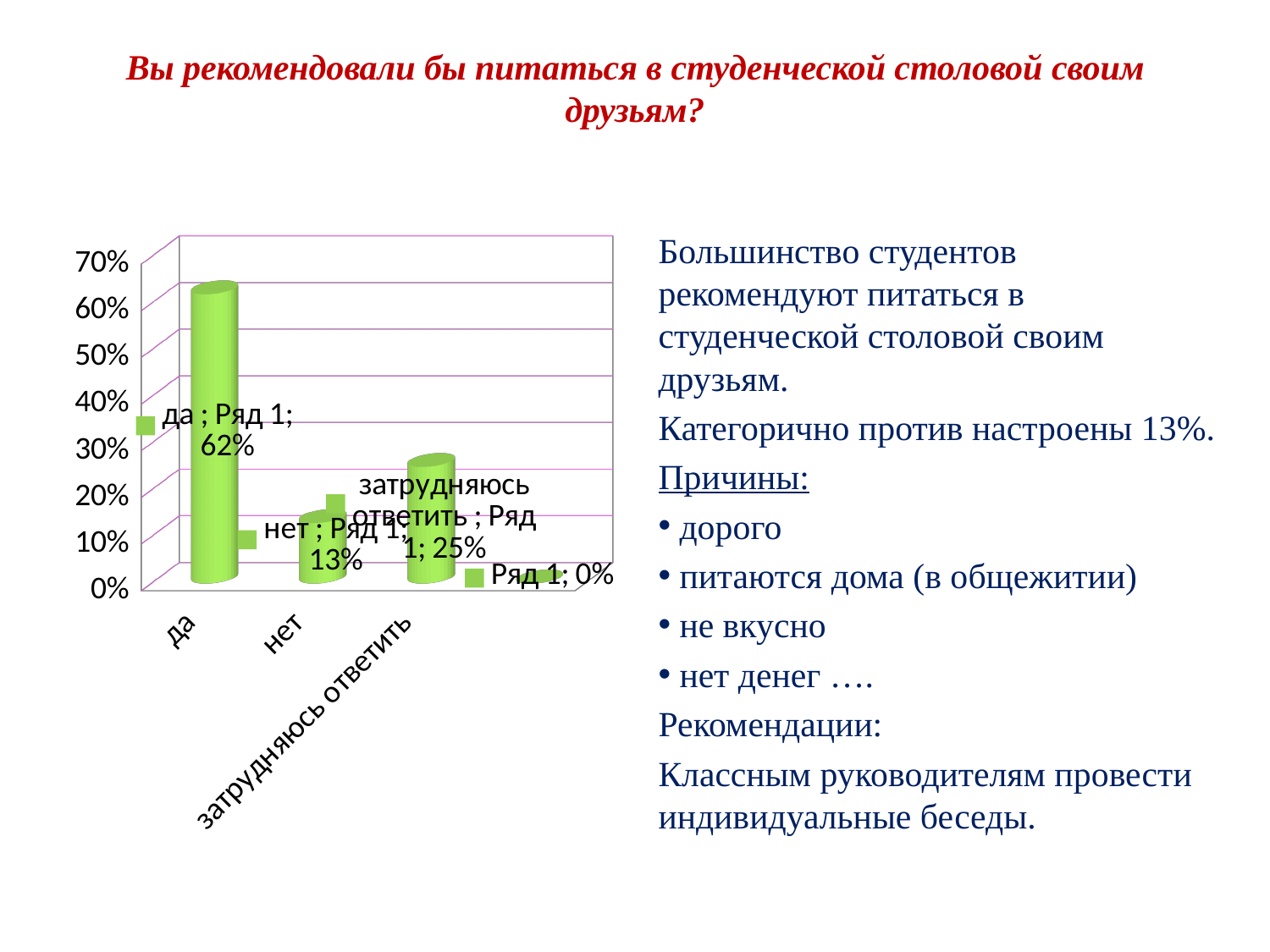
Is the value for "да" greater or less than 50%? greater What is the difference between the values for "затрудняюсь ответить" and "нет"? 12% What is the highest value shown on the vertical axis? 70% What kind of chart is shown on the slide? bar chart What is the value for "затрудняюсь ответить"? 25% What is the difference between the values for "да" and "нет"? 49% Which of the labelled categories has the lowest value? нет What is the value for "нет"? 13% Which category has the highest value? да Which is larger, the value for "нет" or the value for "затрудняюсь ответить"? затрудняюсь ответить What is the name of the data series shown in the chart? Ряд 1 What is the value for "да"? 62%